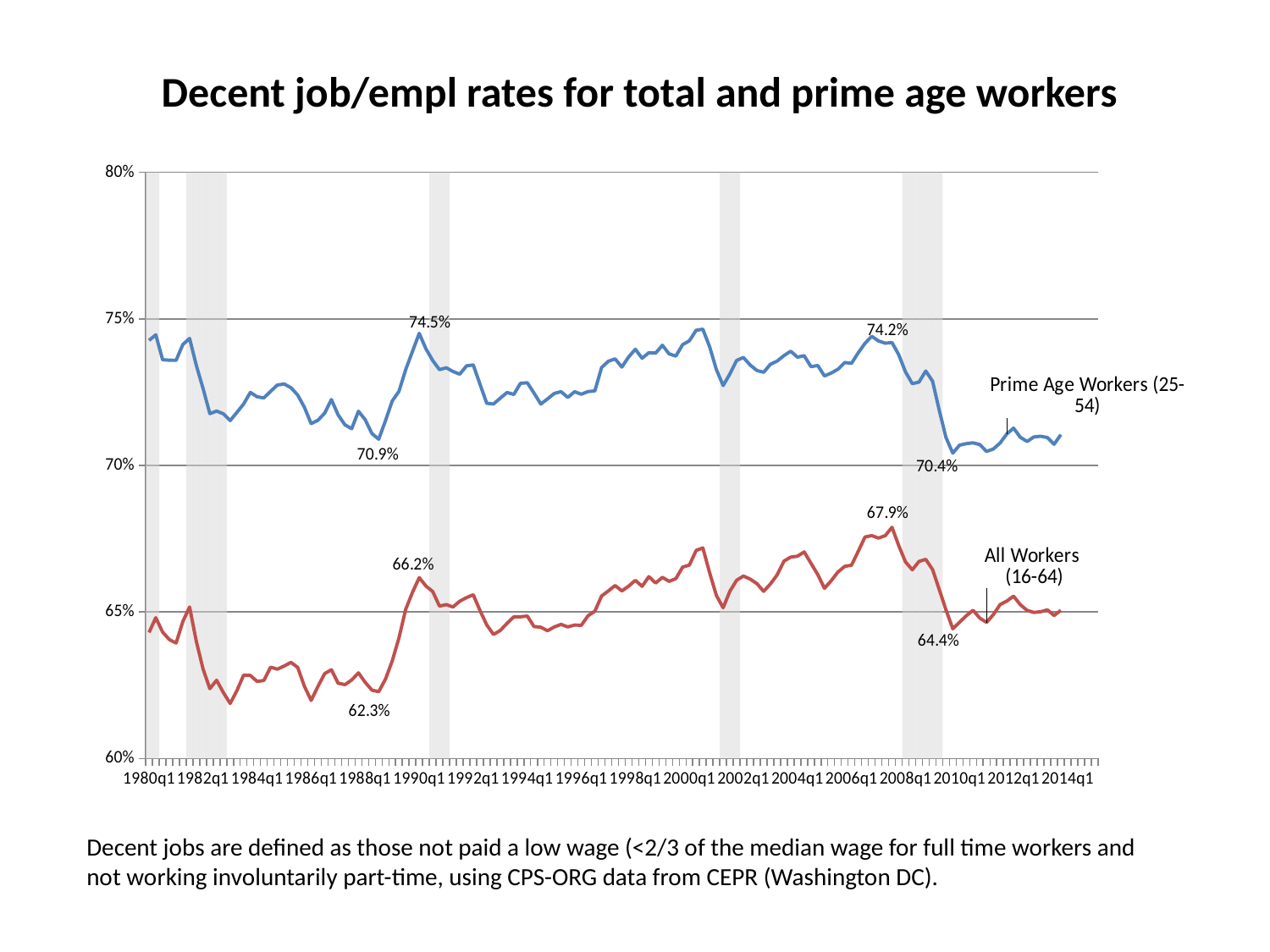
What is the difference between the labeled pre-recession peak (67.9%) and the labeled 2010 low (64.4%) for All Workers? 3.5 percentage points Is the Prime Age Workers (25-54) value at 2000q1 greater or less than 70%? greater What is the difference between the labeled 1990 peak (74.5%) and the preceding labeled low (70.9%) for Prime Age Workers? 3.6 percentage points What is the labeled peak value of the All Workers (16-64) series just before the 2008 recession? 67.9% Does the Prime Age Workers (25-54) series rise or fall between 2008q1 and 2010q1? Fall What is the labeled peak value of the Prime Age Workers (25-54) series around 1990? 74.5% What type of chart is shown on the slide? Line chart What is the labeled low value of the All Workers (16-64) series in the late 1980s? 62.3% What is the title of the chart? Decent job/empl rates for total and prime age workers How many series are plotted on the chart? 2 Which series has higher values throughout the chart, Prime Age Workers (25-54) or All Workers (16-64)? Prime Age Workers (25-54) What is the labeled low value of the Prime Age Workers (25-54) series around 2010? 70.4%